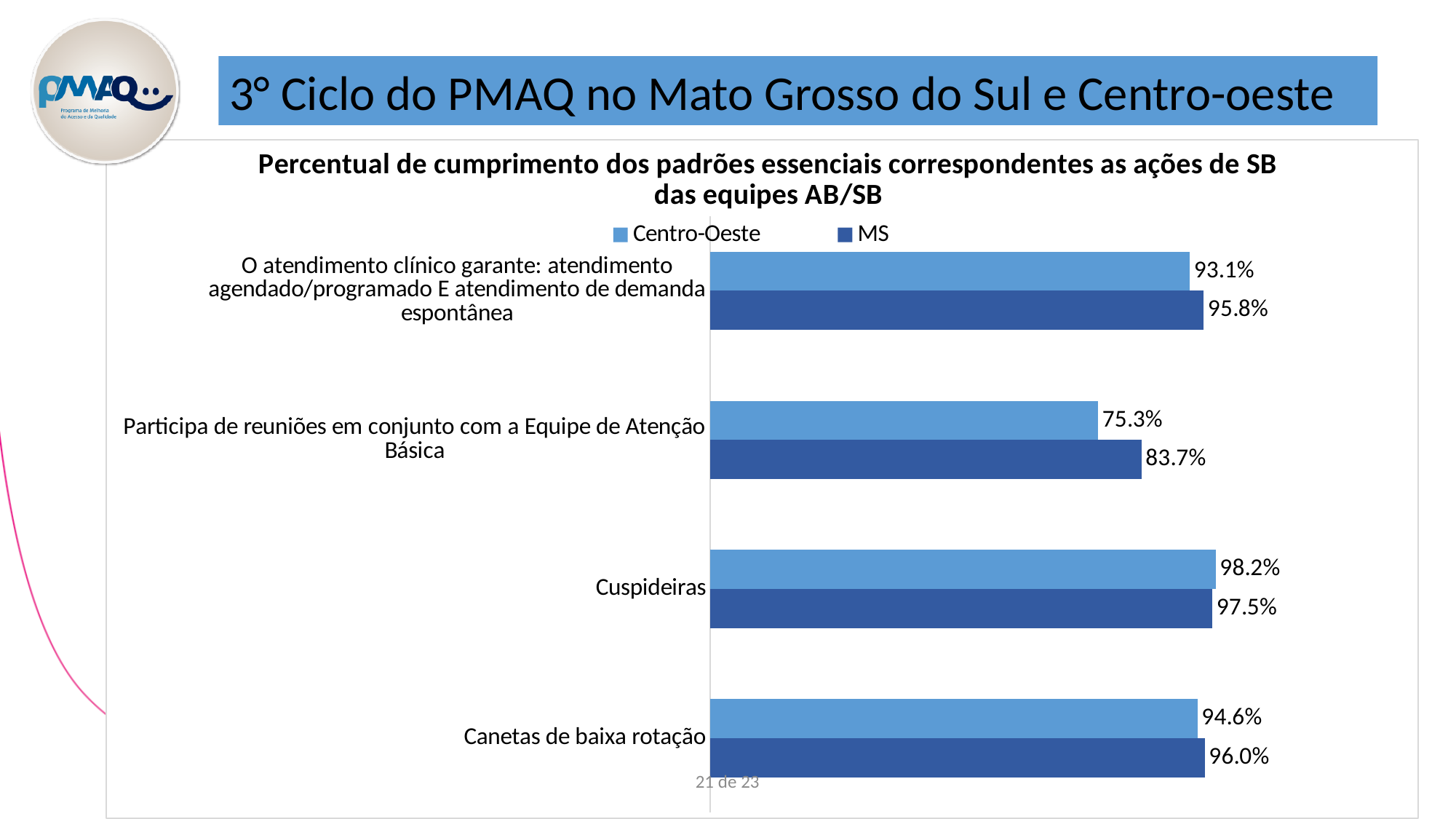
Which series is shown in the darker blue colour? MS What is the Centro-Oeste value for Cuspideiras? 98.2% How many series does the legend list? 2 What is the difference between the MS and Centro-Oeste values for Participa de reuniões em conjunto com a Equipe de Atenção Básica? 8.4% What is the Centro-Oeste value for the category 'O atendimento clínico garante: atendimento agendado/programado E atendimento de demanda espontânea'? 93.1% What type of chart is shown on the slide? Bar chart For Canetas de baixa rotação, which series has the larger value, Centro-Oeste or MS? MS How many categories are shown in the chart? 4 What is the MS value for Participa de reuniões em conjunto com a Equipe de Atenção Básica? 83.7% What is the MS value for Canetas de baixa rotação? 96.0% Which category has the lowest Centro-Oeste value? Participa de reuniões em conjunto com a Equipe de Atenção Básica Which category has the highest MS value? Cuspideiras